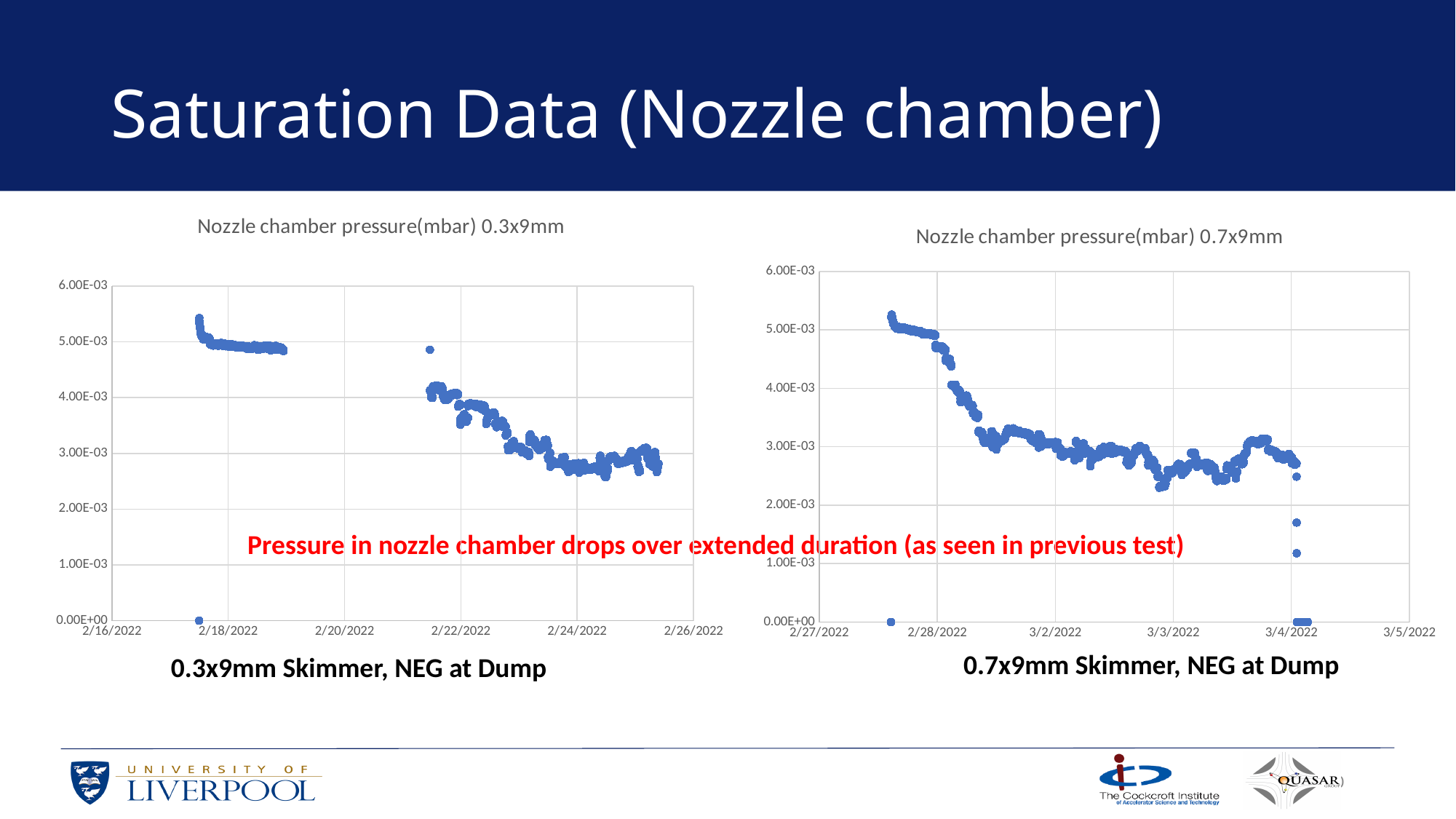
What kind of chart is the left chart, titled 'Nozzle chamber pressure(mbar) 0.3x9mm'? Scatter chart In the left chart (0.3x9mm), are the pressure values around 2/22/2022 greater or less than 5.00E-03? less In the right chart (0.7x9mm), are the pressure values around 2/28/2022 greater or less than 4.00E-03? greater In the left chart (0.3x9mm), do the pressure values generally rise or fall over time along the x axis? Fall In the right chart (0.7x9mm), do the pressure values generally rise or fall over time along the x axis? Fall What is the highest value shown on the y axis of the right chart (0.7x9mm)? 6.00E-03 In the left chart (0.3x9mm), are the pressure values around 2/18/2022 greater or less than 4.00E-03? greater What is the title of the left chart? Nozzle chamber pressure(mbar) 0.3x9mm What kind of chart is the right chart, titled 'Nozzle chamber pressure(mbar) 0.7x9mm'? Scatter chart